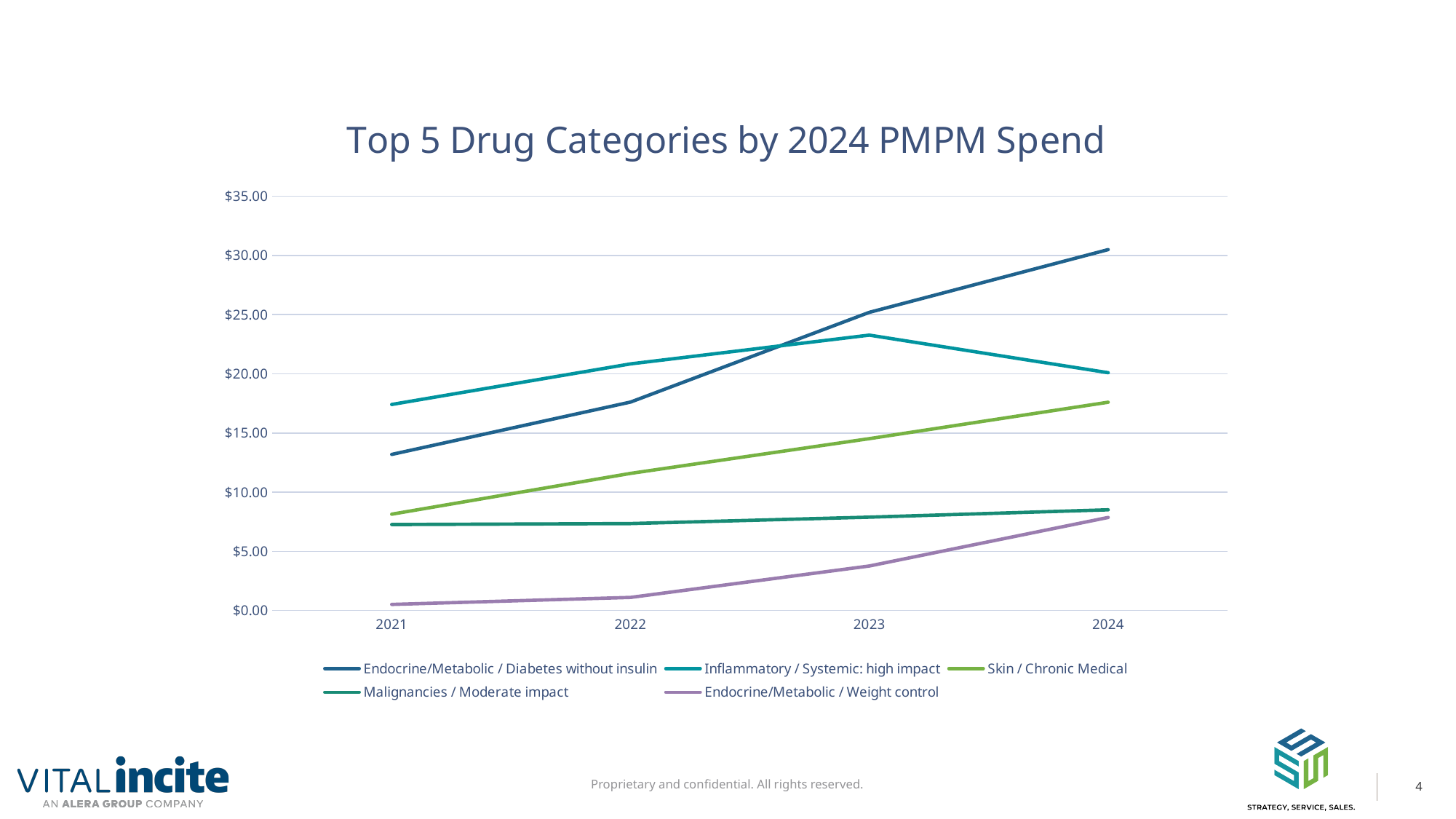
What kind of chart is shown on the slide? Line chart How many years are shown on the x axis? 4 What is the title of the chart? Top 5 Drug Categories by 2024 PMPM Spend Which drug category has the lowest PMPM spend in 2021? Endocrine/Metabolic / Weight control Which drug category has the highest PMPM spend in 2024? Endocrine/Metabolic / Diabetes without insulin How many series does the legend list? 5 Does the PMPM spend for Endocrine/Metabolic / Weight control rise or fall from 2021 to 2024? Rise Is the 2024 value for Endocrine/Metabolic / Diabetes without insulin greater or less than $25.00? greater Which drug category has the highest PMPM spend in 2021? Inflammatory / Systemic: high impact In 2021, which is larger: the value for Inflammatory / Systemic: high impact or the value for Endocrine/Metabolic / Diabetes without insulin? Inflammatory / Systemic: high impact Is the 2024 value for Inflammatory / Systemic: high impact greater or less than $25.00? less Is the 2021 value for Skin / Chronic Medical greater or less than $10.00? less